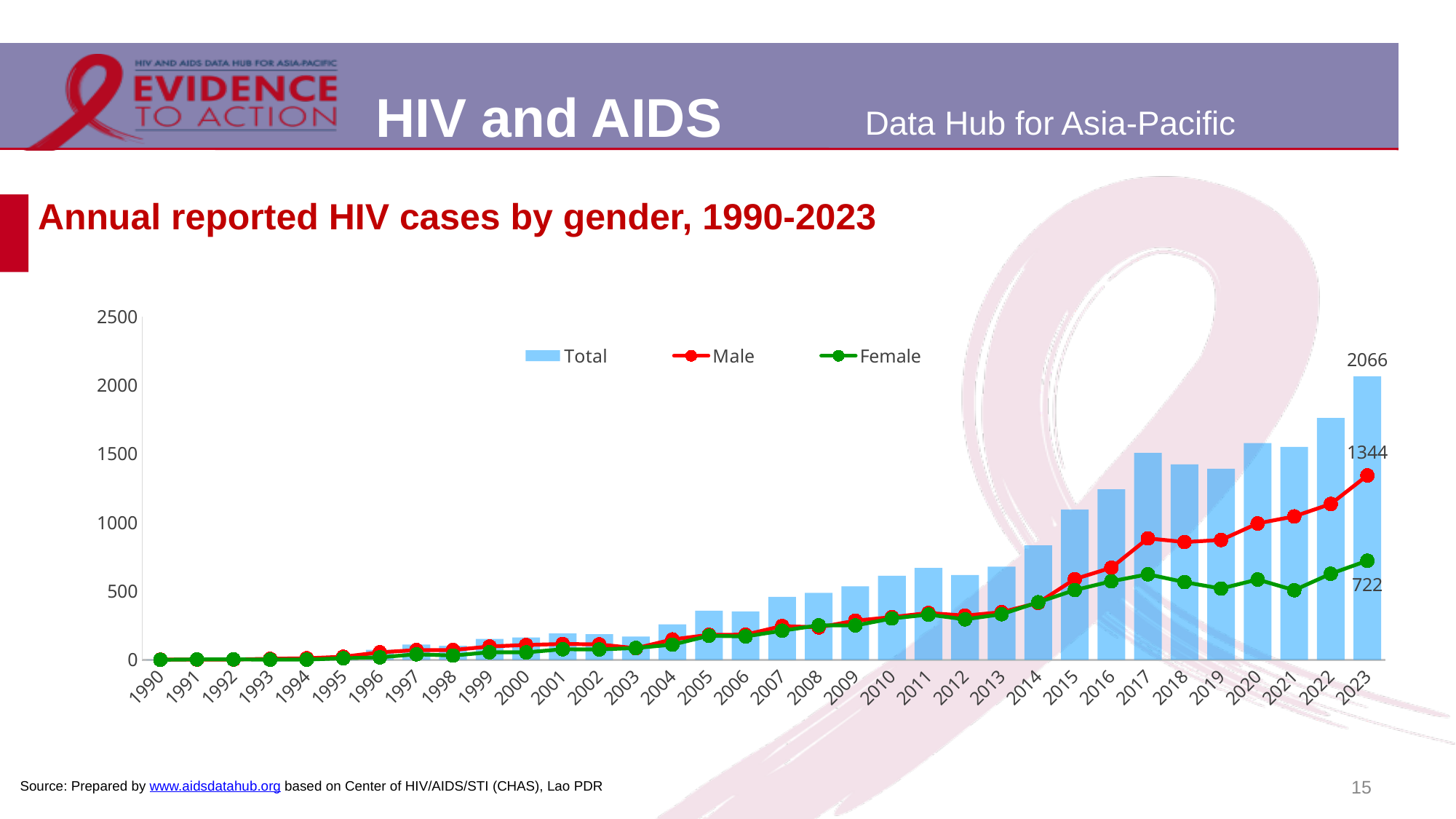
Which year has the highest Total value? 2023 What is the Male value for 2023? 1344 How many series does the legend list? 3 In 2023, which is larger, the Male value or the Female value? Male What is the Female value for 2023? 722 What is the title of the chart? Annual reported HIV cases by gender, 1990-2023 What is the difference between the Male and Female values in 2023? 622 Do the Total values generally rise or fall from 1990 to 2023? rise What is the Total value for 2023? 2066 How many years are shown on the x axis? 34 Is the Male value for 2017 greater or less than 1000? less Is the Total value for 2015 greater or less than 1000? greater